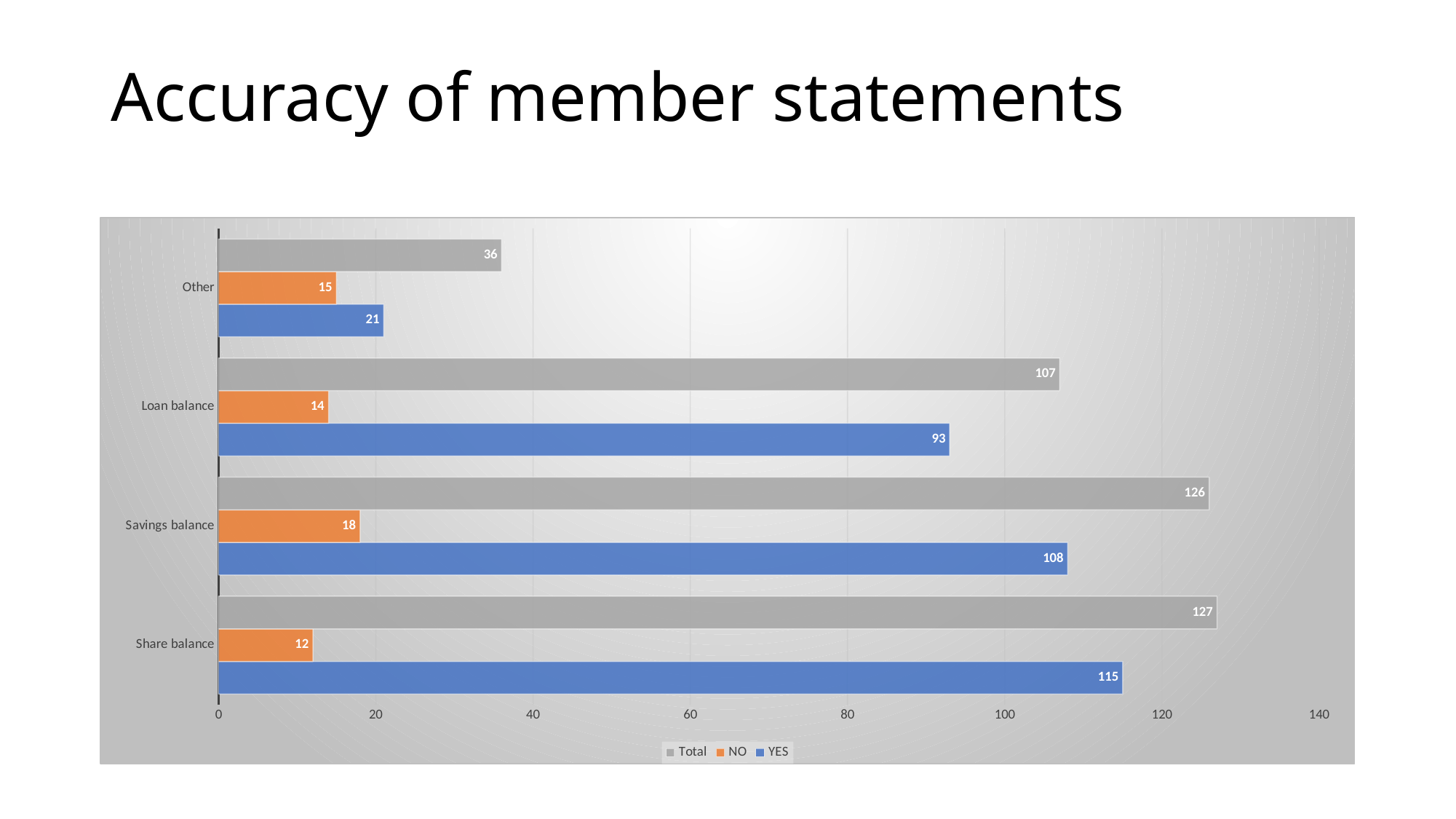
Which category has the highest Total value? Share balance Which is larger, the NO value for Savings balance or the NO value for Other? Savings balance What kind of chart is shown on the slide? bar chart What is the NO value for Loan balance? 14 How many series does the legend list? 3 What is the YES value for Share balance? 115 Which category has the lowest YES value? Other What is the difference between the YES values for Savings balance and Loan balance? 15 How many categories are shown on the chart? 4 What colour are the NO bars? orange What is the Total value for Other? 36 Is the YES value for Loan balance greater or less than 100? less